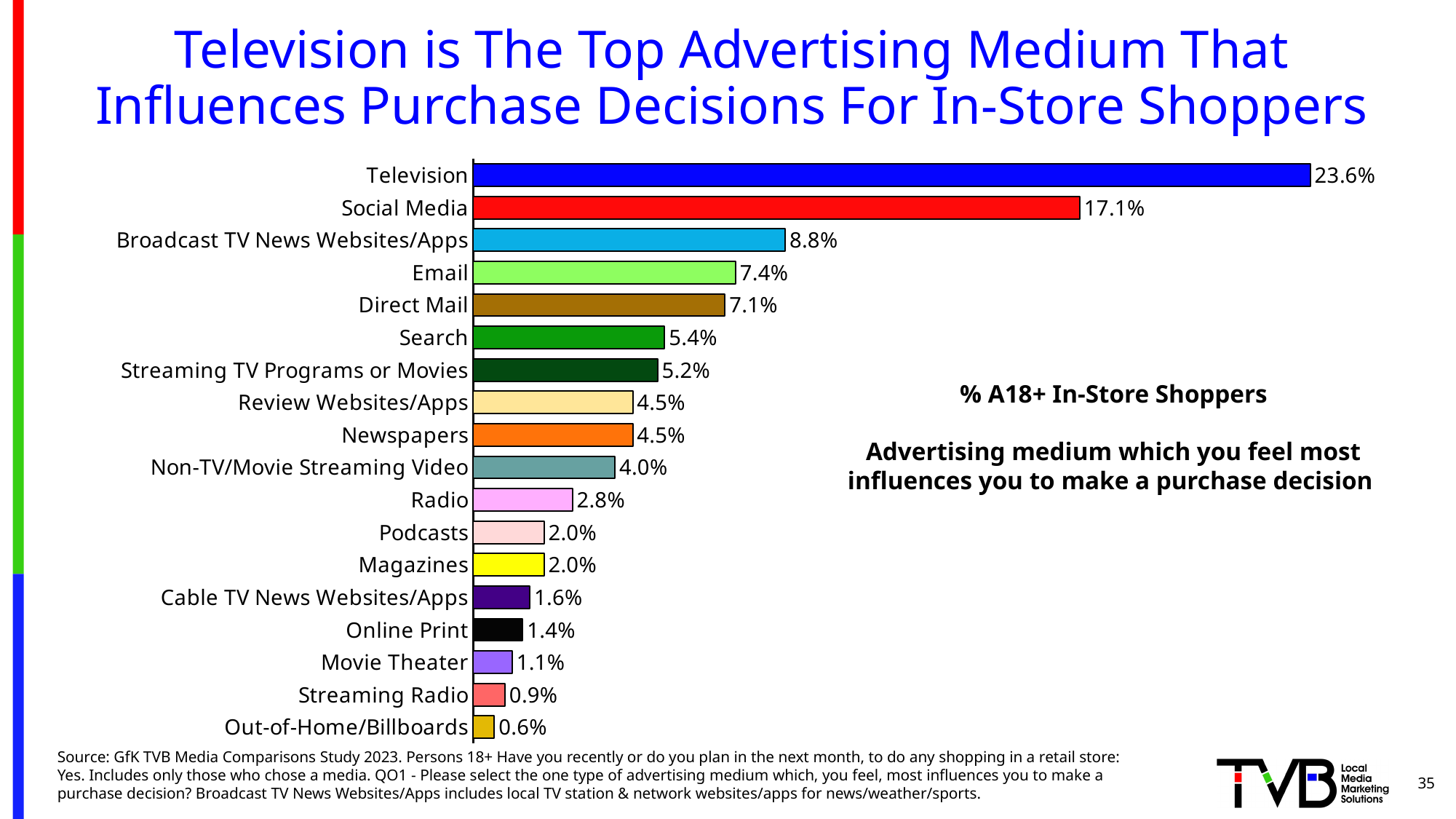
What colour is the bar for Television? Blue What is the value shown for Social Media? 17.1% What is the value shown for Direct Mail? 7.1% Which advertising medium has the lowest value on the chart? Out-of-Home/Billboards What percentage of in-store shoppers chose Television as the advertising medium that most influences their purchase decision? 23.6% How many advertising media are listed on the chart? 18 Which advertising medium has the highest value on the chart? Television What is the difference between the values for Television and Social Media? 6.5% What kind of chart is shown on the slide? Bar chart Which has a larger value, Radio or Non-TV/Movie Streaming Video? Non-TV/Movie Streaming Video What is the difference between the values for Email and Direct Mail? 0.3% Which has a larger value, Search or Streaming TV Programs or Movies? Search